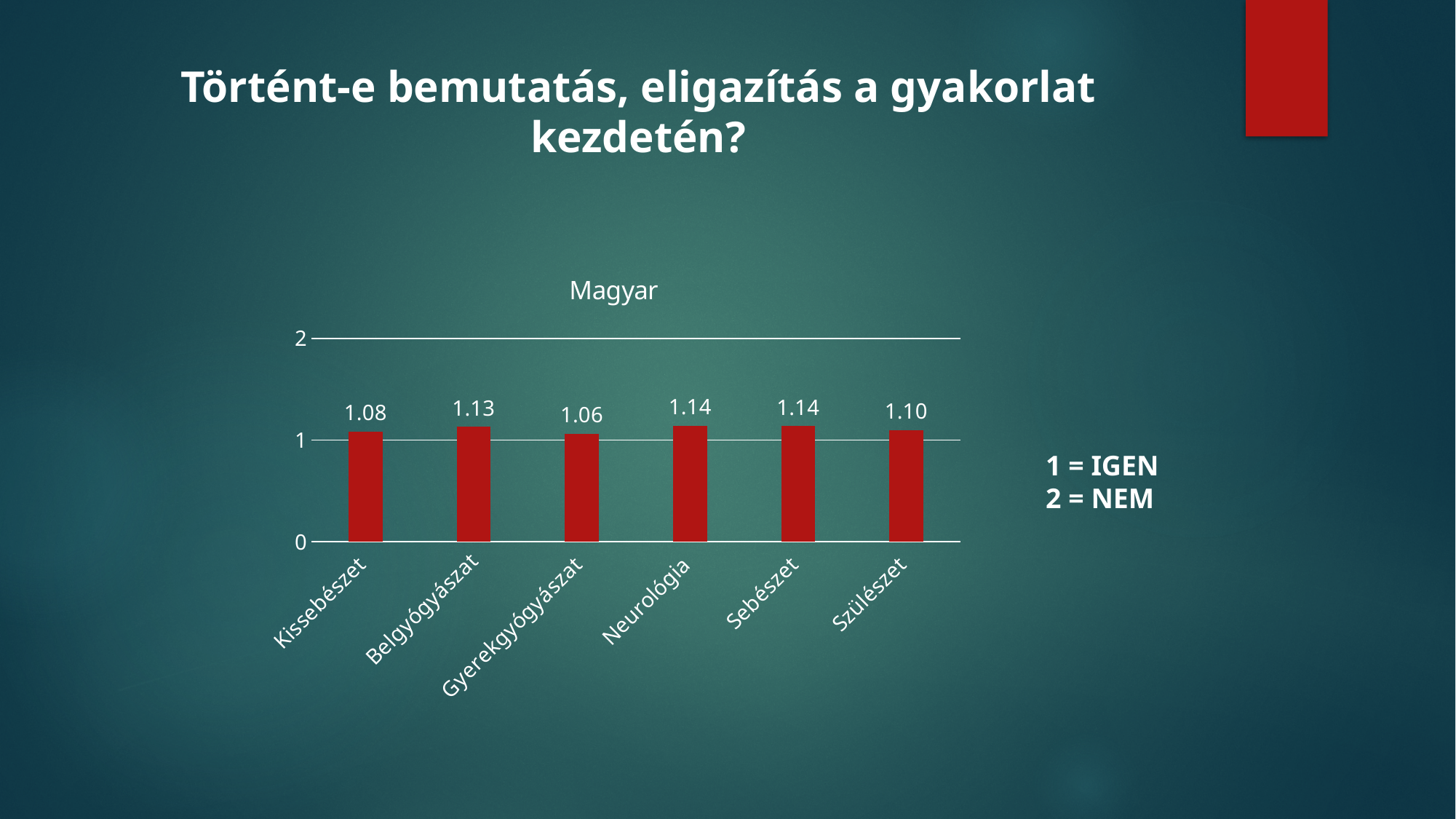
What is the title of the chart? Magyar How many categories are shown on the x axis? 6 What is the value for Kissebészet? 1.08 What is the value for Szülészet? 1.10 What is the difference between the values for Belgyógyászat and Gyerekgyógyászat? 0.07 Which category has the lowest value? Gyerekgyógyászat What is the difference between the values for Neurológia and Kissebészet? 0.06 Which is larger, the value for Belgyógyászat or the value for Szülészet? Belgyógyászat What kind of chart is shown on the slide? bar chart What is the value for Gyerekgyógyászat? 1.06 What is the value for Belgyógyászat? 1.13 Is the value for Sebészet greater or less than 1? greater